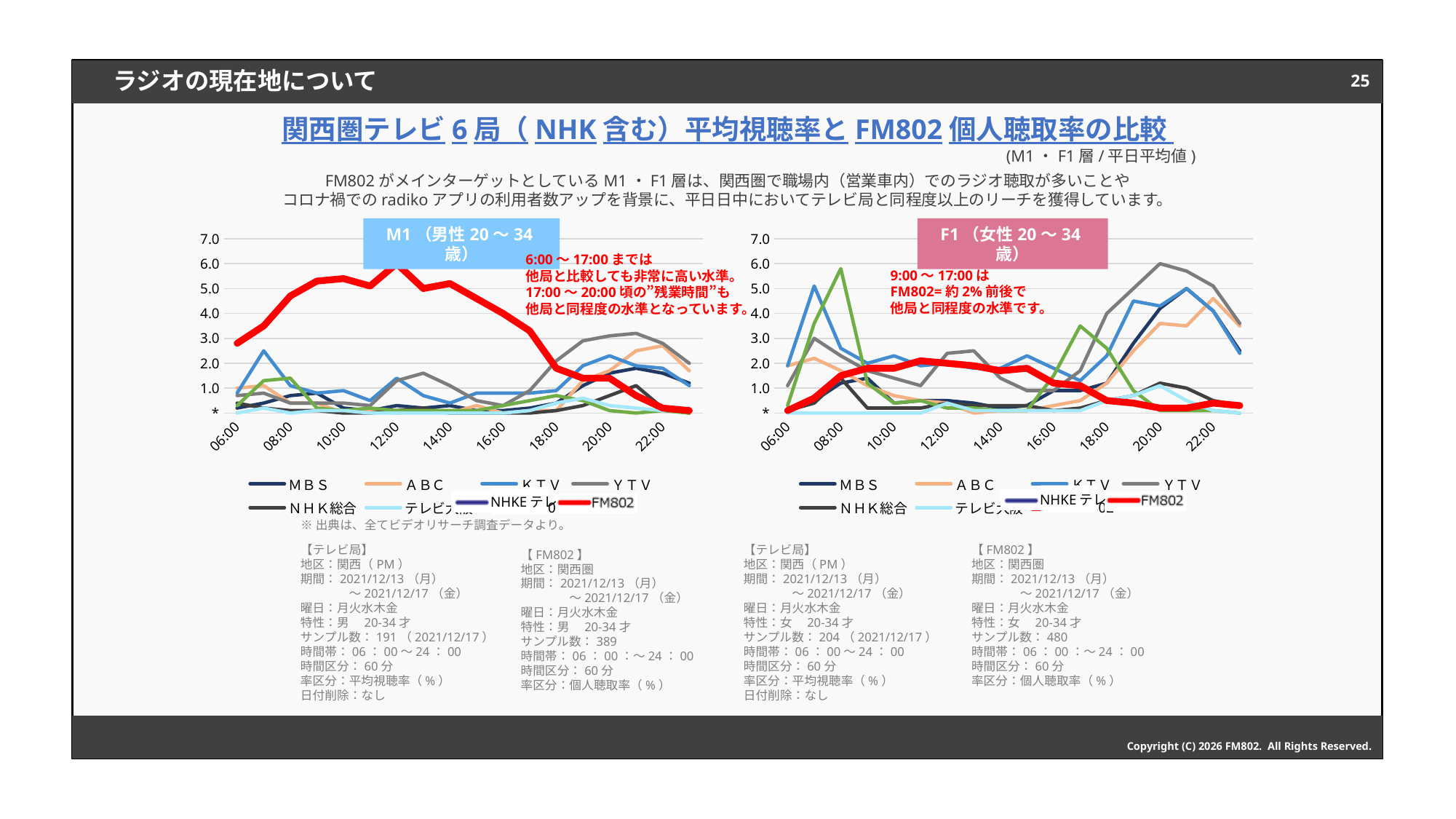
In the M1 chart, which is larger at 10:00: FM802 or KTV? FM802 In the M1 chart, is the FM802 value at 22:00 greater or less than 1.0? less What kind of chart is the M1 (男性 20～34歳) chart on the left? line chart How many time labels are shown on the x axis of the F1 chart? 9 In the F1 chart, is the YTV value at 20:00 greater or less than 5.0? greater In the F1 chart, is the FM802 value at 22:00 greater or less than 1.0? less How many series does the legend of the F1 (女性 20～34歳) chart list? 8 In the M1 chart, which series reaches the highest value on the chart? FM802 In the M1 chart, does the FM802 line rise or fall from 12:00 to 22:00? fall What colour is the FM802 line in both charts? red